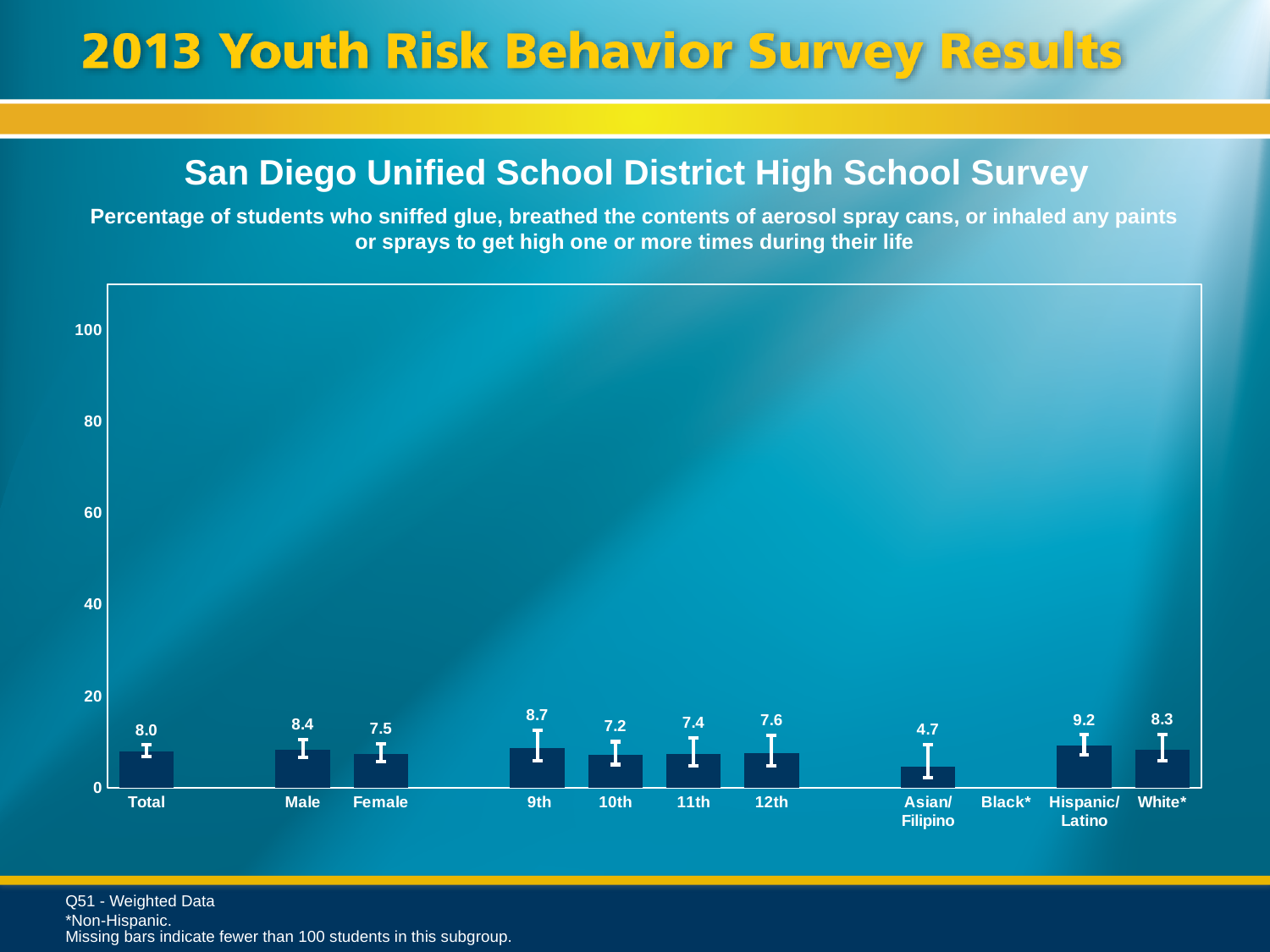
What is the value for 9th grade? 8.7 What is the value for Asian/Filipino? 4.7 Which category has the highest value? Hispanic/Latino What is the value for Total? 8.0 Which is larger, the value for 10th grade or 12th grade? 12th Is the value for White* greater or less than 20? less What kind of chart is shown? bar chart What is the difference between the Male and Female values? 0.9 What is the value for Female? 7.5 Which category has no bar shown? Black* How many categories are labelled on the x axis? 11 Which category with a bar has the lowest value? Asian/Filipino